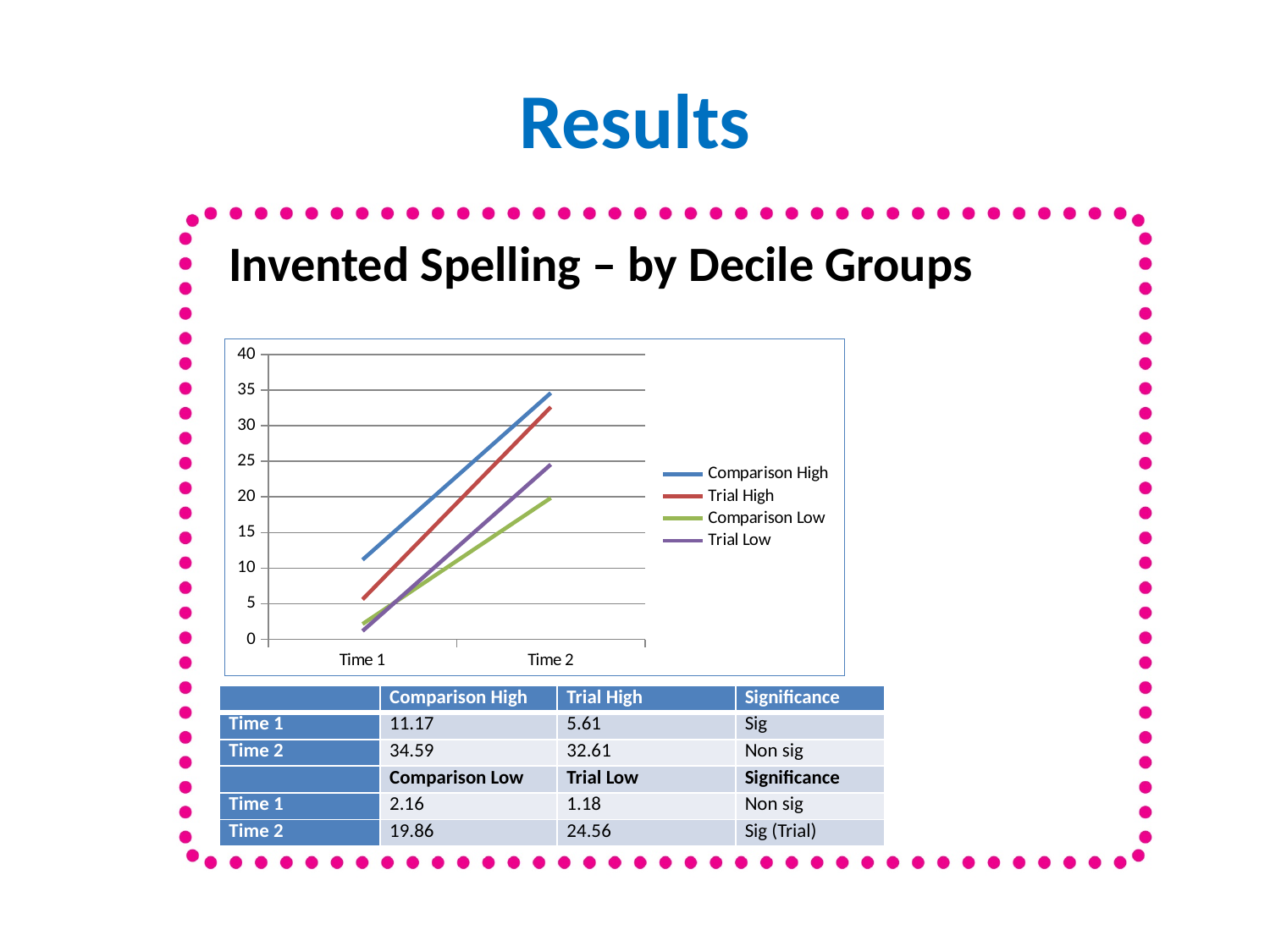
According to the table, what is the Trial Low value at Time 1? 1.18 Using the table values, what is the difference between Comparison High and Trial High at Time 1? 5.56 Do the values for Trial Low rise or fall from Time 1 to Time 2? rise How many time points are shown on the x axis of the chart? 2 What is the title of the chart? Invented Spelling – by Decile Groups Which series has the lowest value at Time 1? Trial Low How many series does the chart legend list? 4 Is the value for Trial High at Time 2 greater or less than 30? greater Which series has the highest value at Time 2? Comparison High According to the table, what is the Comparison High value at Time 2? 34.59 At Time 2, which is larger: Comparison Low or Trial Low? Trial Low What kind of chart is shown on the slide? line chart